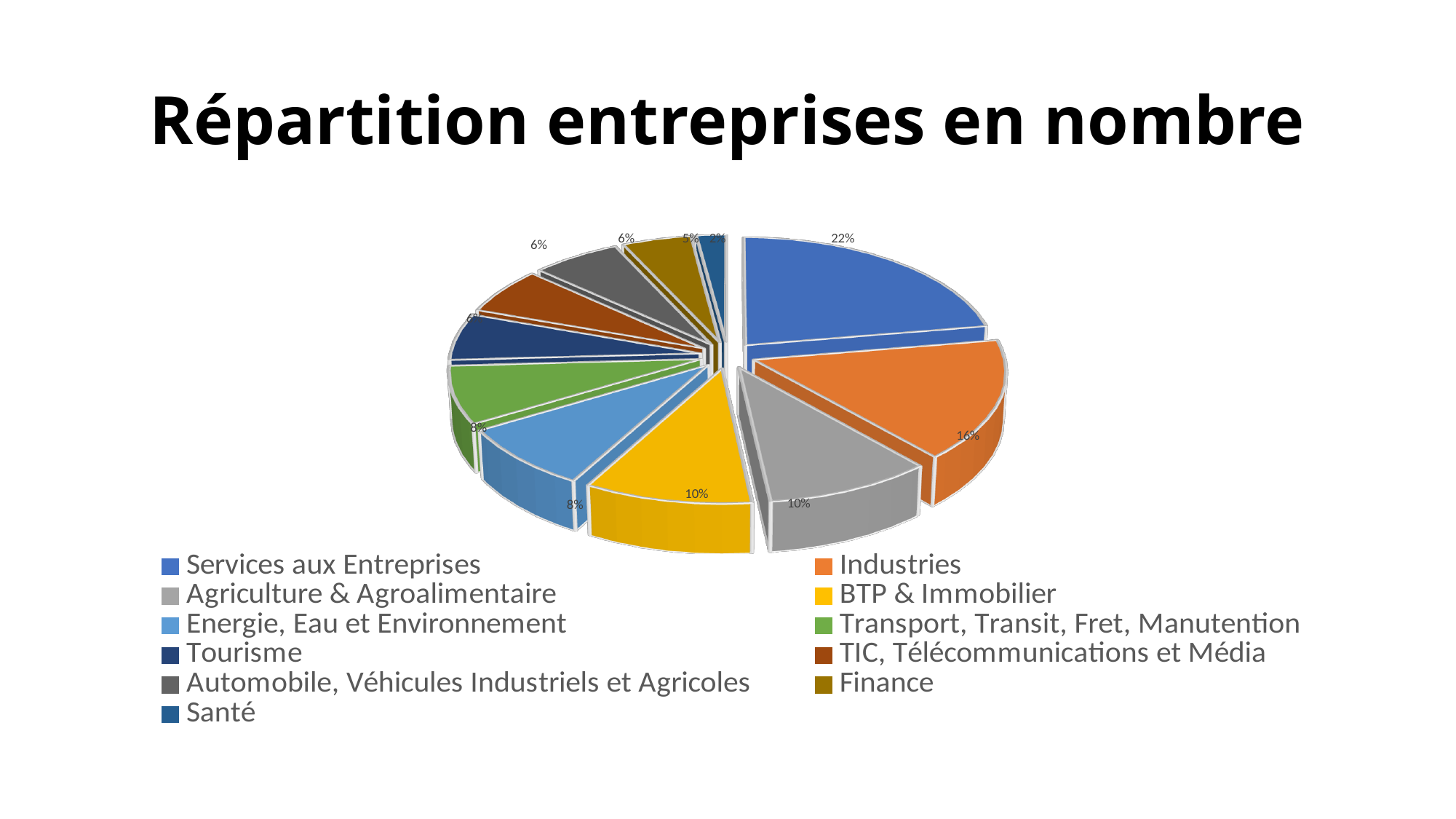
What percentage is shown for Finance? 5% How many categories does the legend list? 11 By how many percentage points does Services aux Entreprises exceed Industries? 6 percentage points What is the title of the slide? Répartition entreprises en nombre Which category has the smallest slice of the pie? Santé What percentage is shown for Energie, Eau et Environnement? 8% What share of the pie does Services aux Entreprises hold? 22% What kind of chart is shown on the slide? pie chart Which category has the largest slice of the pie? Services aux Entreprises What percentage is shown for Industries? 16% Which is larger, the slice for Industries or the slice for Agriculture & Agroalimentaire? Industries What percentage is shown for BTP & Immobilier? 10%